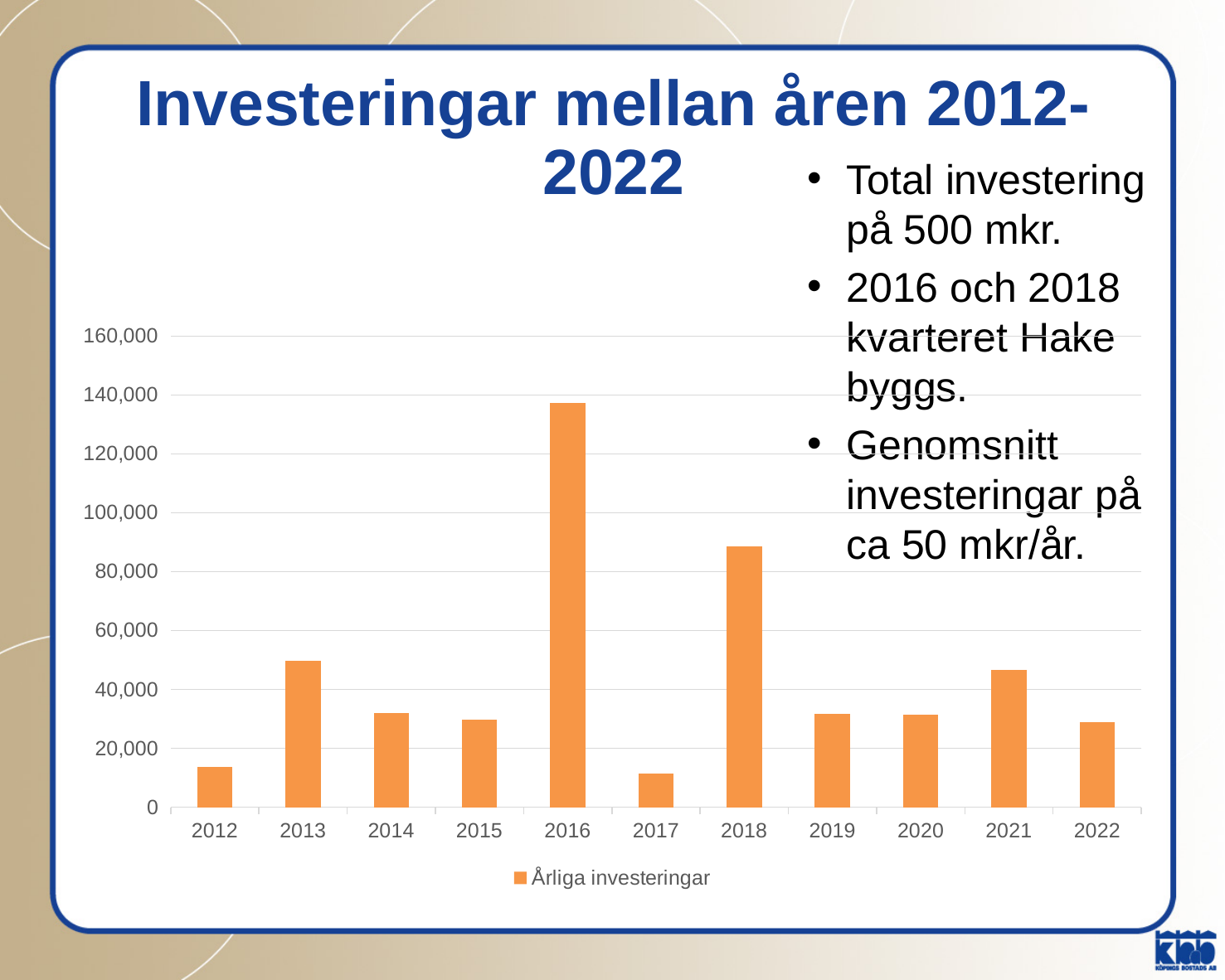
How many series does the chart's legend list? 1 What kind of chart is shown on the slide? bar chart Which year has the larger value, 2013 or 2014? 2013 Is the value for 2021 greater or less than 40,000? greater How many years are shown on the x axis of the chart? 11 Which year has the larger value, 2016 or 2018? 2016 Is the value for 2016 greater or less than 120,000? greater Is the value for 2017 greater or less than 20,000? less What is the name of the series shown in the chart's legend? Årliga investeringar Which year has the highest value in the chart? 2016